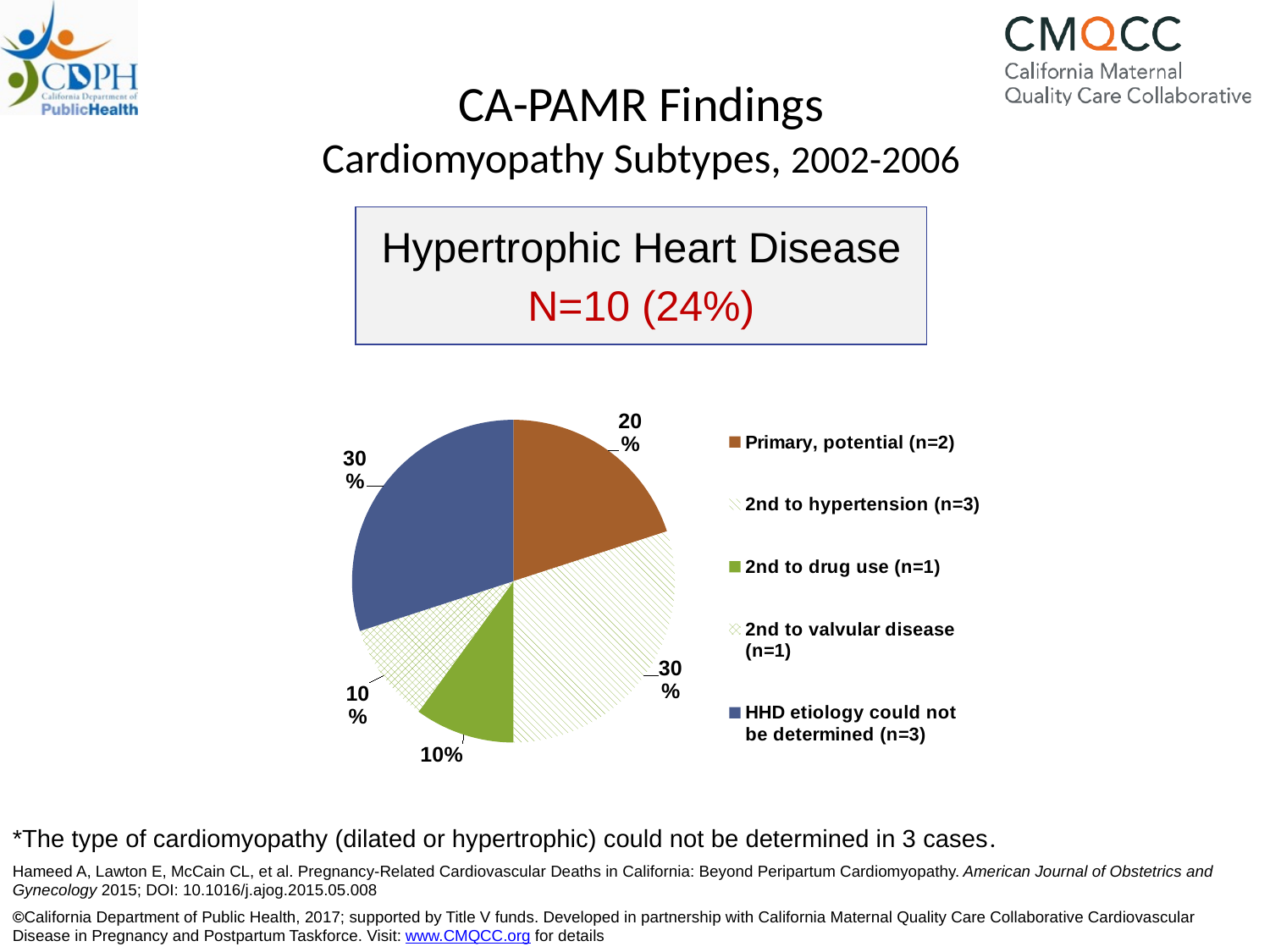
What is the subtitle of the slide below "CA-PAMR Findings"? Cardiomyopathy Subtypes, 2002-2006 What type of chart is shown on the slide? pie chart How many entries does the legend list? 5 What is the difference in percentage points between the "2nd to hypertension (n=3)" slice and the "2nd to valvular disease (n=1)" slice? 20 percentage points What percentage of the pie is the "Primary, potential (n=2)" slice? 20% What percentage of the pie is the "2nd to hypertension (n=3)" slice? 30% Which is larger: the "Primary, potential (n=2)" slice or the "2nd to drug use (n=1)" slice? Primary, potential (n=2) How many cases (n) are in the "2nd to hypertension" legend entry? 3 What percentage of the pie is the "2nd to drug use (n=1)" slice? 10% What is the total number of cases (N) shown in the box above the pie chart? 10 How many slices does the pie chart have? 5 What percentage of the pie is the "HHD etiology could not be determined (n=3)" slice? 30%